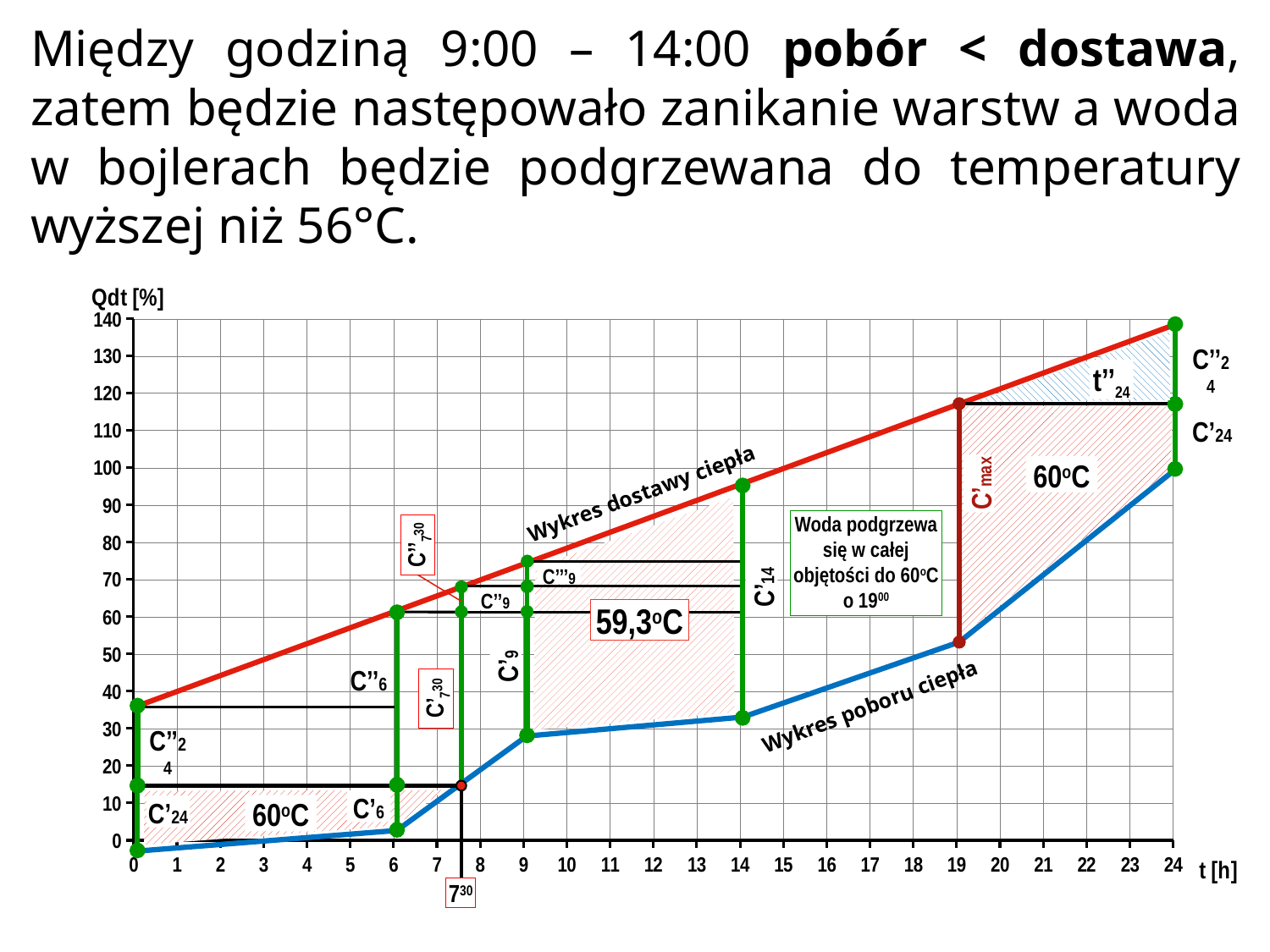
Is the value of 'Wykres dostawy ciepła' at t = 9 h greater or less than 70? greater Is the value of 'Wykres poboru ciepła' at t = 9 h greater or less than 40? less Does the 'Wykres dostawy ciepła' line rise or fall as t increases from 0 to 24 h? rise What is the label of the vertical axis of the chart? Qdt [%] Is the value of 'Wykres dostawy ciepła' at t = 19 h greater or less than 110? greater What is the highest value shown on the vertical axis of the chart? 140 What temperature is printed in the hatched area between the two lines between t = 9 h and t = 14 h? 59,3°C At t = 14 h, which line is higher: 'Wykres dostawy ciepła' or 'Wykres poboru ciepła'? Wykres dostawy ciepła What kind of chart is shown on the slide? line chart What is the label of the horizontal axis of the chart? t [h]